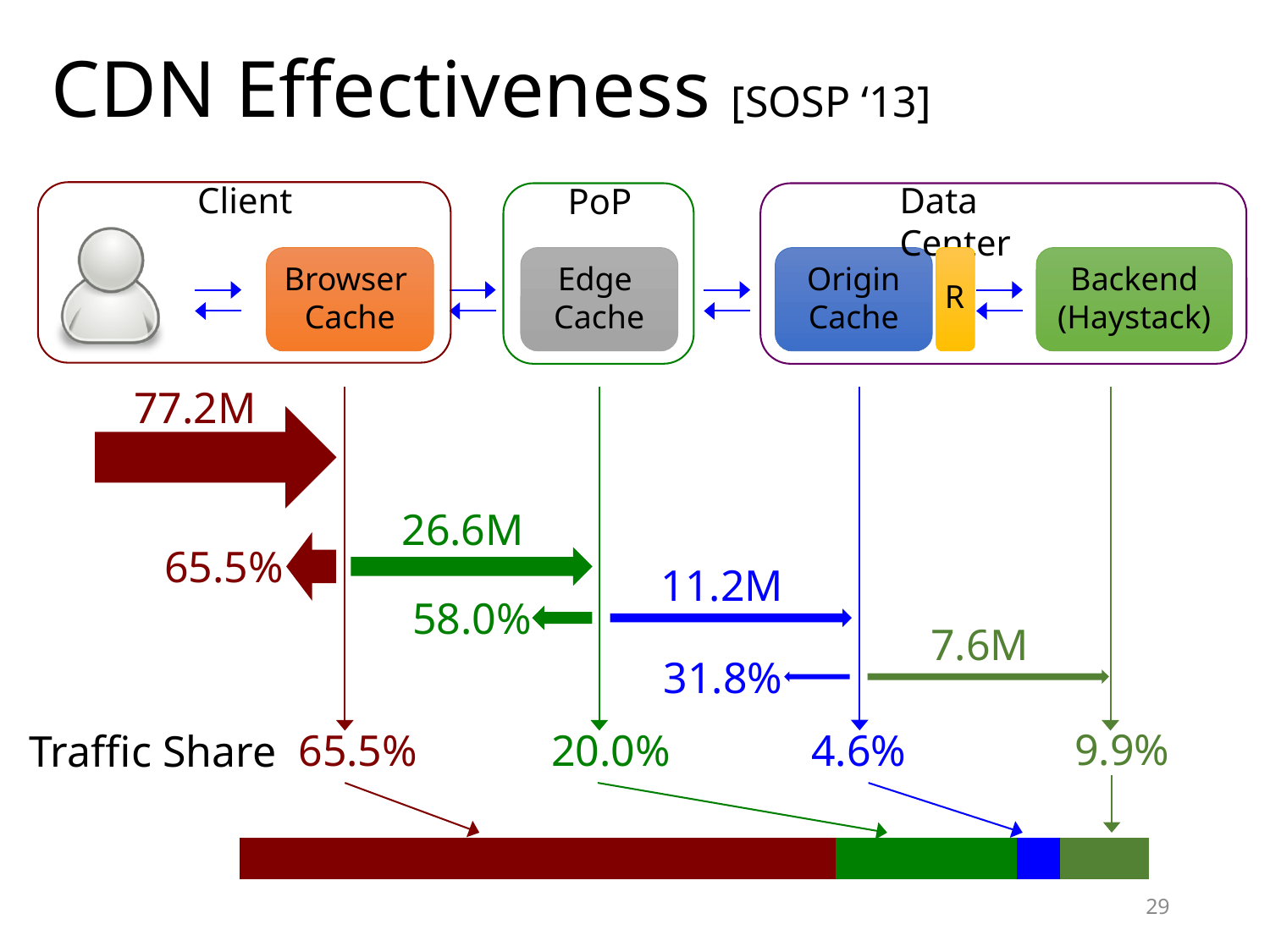
How many requests reach the Backend (Haystack) according to the flow diagram? 7.6M What is the difference between the Browser Cache traffic share and the Edge Cache traffic share? 45.5% In the Traffic Share bar, what share of traffic is served by the Browser Cache? 65.5% Which tier has the largest traffic share? Browser Cache In the Traffic Share bar, what share of traffic is served by the Backend (Haystack)? 9.9% Which has the larger traffic share, the Backend (Haystack) or the Origin Cache? Backend (Haystack) In the Traffic Share bar, what share of traffic is served by the Edge Cache? 20.0% How many segments make up the Traffic Share stacked bar? 4 In the Traffic Share bar, what share of traffic is served by the Origin Cache? 4.6% What kind of chart is shown at the bottom of the slide for Traffic Share? Stacked bar chart How many requests reach the Edge Cache according to the flow diagram? 26.6M Which tier has the smallest traffic share? Origin Cache